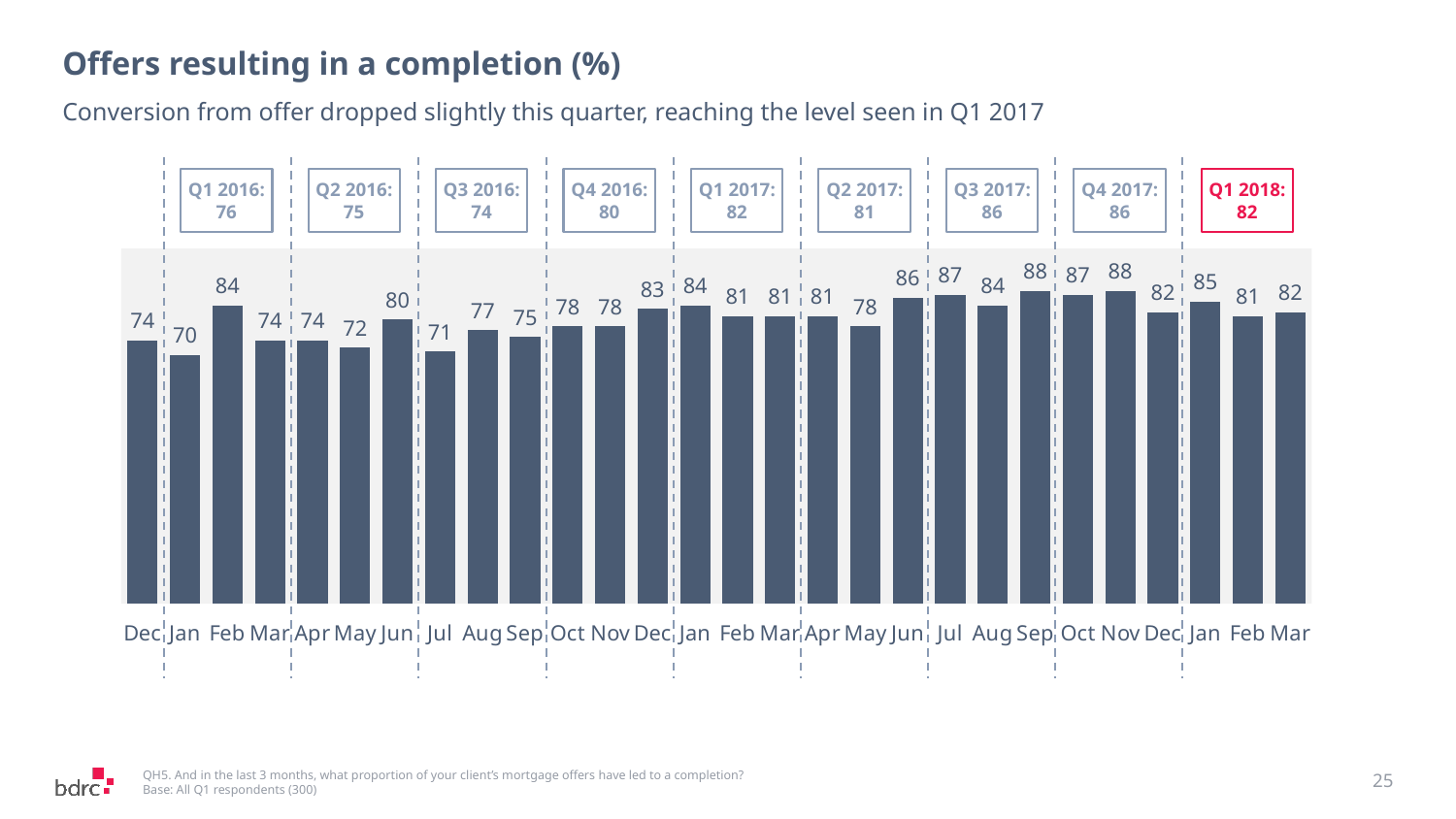
What is the lowest monthly value plotted in the chart? 70 What is the title of the chart? Offers resulting in a completion (%) What is the value for the Jun bar within the Q2 2017 section? 86 What kind of chart is shown on the slide? bar chart How many monthly bars are plotted in the chart? 28 What is the quarterly value shown in the box for Q1 2018? 82 How many quarterly summary boxes are shown above the chart? 9 What is the highest monthly value plotted in the chart? 88 What is the difference between the quarterly values for Q4 2016 and Q3 2016? 6 Which quarter has the higher value, Q1 2017 or Q2 2017? Q1 2017 What is the quarterly value shown in the box for Q3 2017? 86 What is the difference between the Jan and Feb bars within the Q1 2018 section? 4